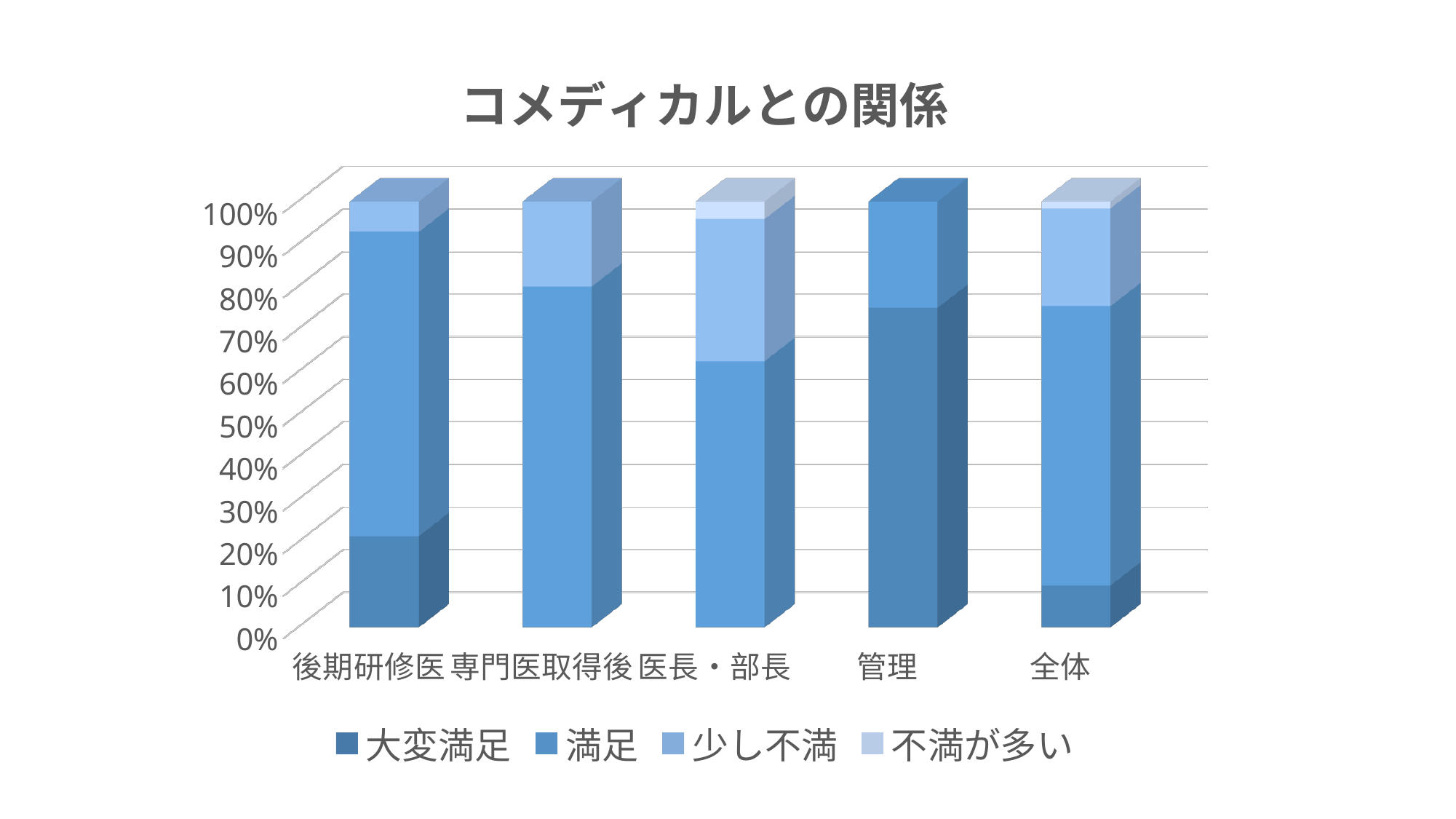
Which is larger, the 少し不満 segment for 医長・部長 or for 後期研修医? 医長・部長 How many categories are shown on the x axis? 5 Is the 大変満足 share for 後期研修医 greater or less than 10%? greater What is the total height of the 全体 stacked bar? 100% Is the 大変満足 share for 後期研修医 greater or less than 30%? less How many series does the legend list? 4 Which is larger, the 大変満足 segment for 管理 or for 後期研修医? 管理 Which category has the largest 大変満足 segment? 管理 Which series is listed last in the legend? 不満が多い What is the title of the chart? コメディカルとの関係 What kind of chart is shown on the slide? Stacked bar chart Is the 大変満足 share for 管理 greater or less than 50%? greater